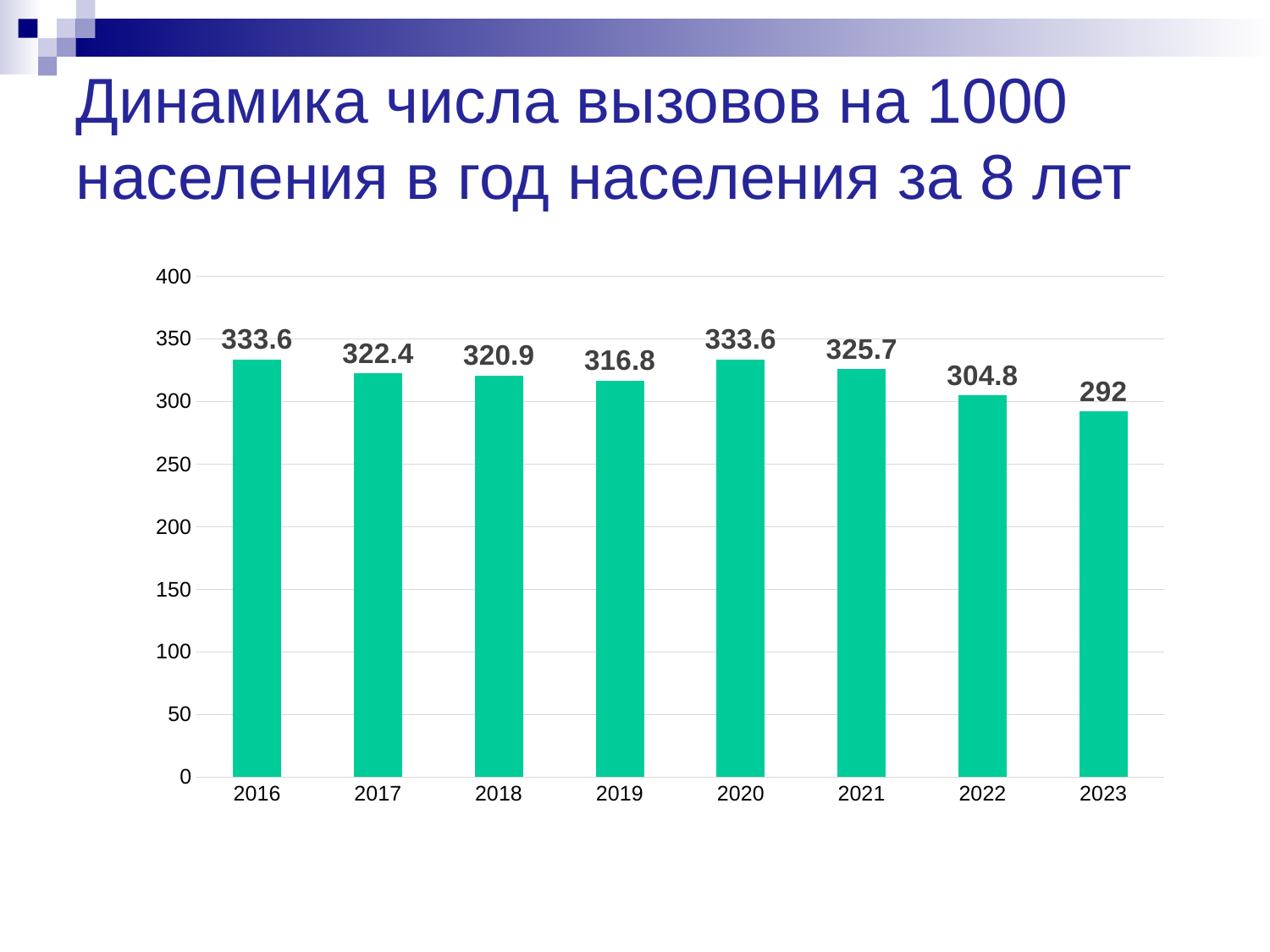
What kind of chart is shown on the slide? Bar chart What is the difference between the values for 2021 and 2022? 20.9 Which year has the lowest value? 2023 How many years are shown on the chart? 8 Do the values rise or fall from 2020 to 2023? Fall What is the value for 2019? 316.8 What is the difference between the values for 2016 and 2023? 41.6 What is the value for 2023? 292 What is the value for 2022? 304.8 Which years share the highest value on the chart? 2016 and 2020 What is the value for 2021? 325.7 Which is larger, the value for 2017 or the value for 2022? 2017